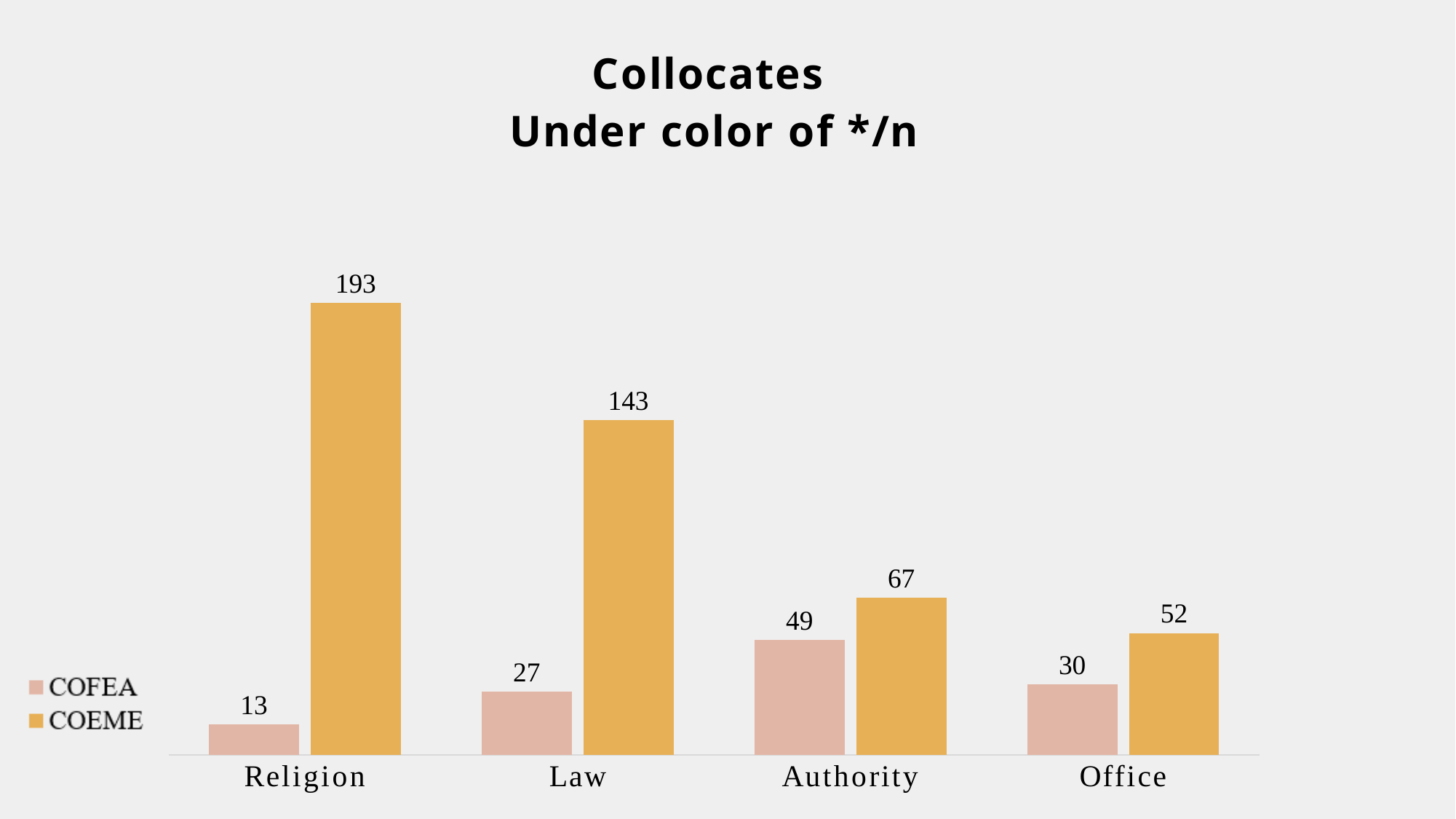
What kind of chart is shown on the slide? Bar chart Which category has the highest COEME value? Religion What is the difference between the COEME and COFEA values for Law? 116 What is the COEME value for Office? 52 How many categories are shown on the x axis? 4 What is the title of the chart? Collocates Under color of */n What is the COFEA value for Law? 27 Which category has the lowest COFEA value? Religion What is the COEME value for Religion? 193 How many series does the legend list? 2 What is the COFEA value for Authority? 49 Which is larger, the COFEA value for Authority or the COFEA value for Office? Authority